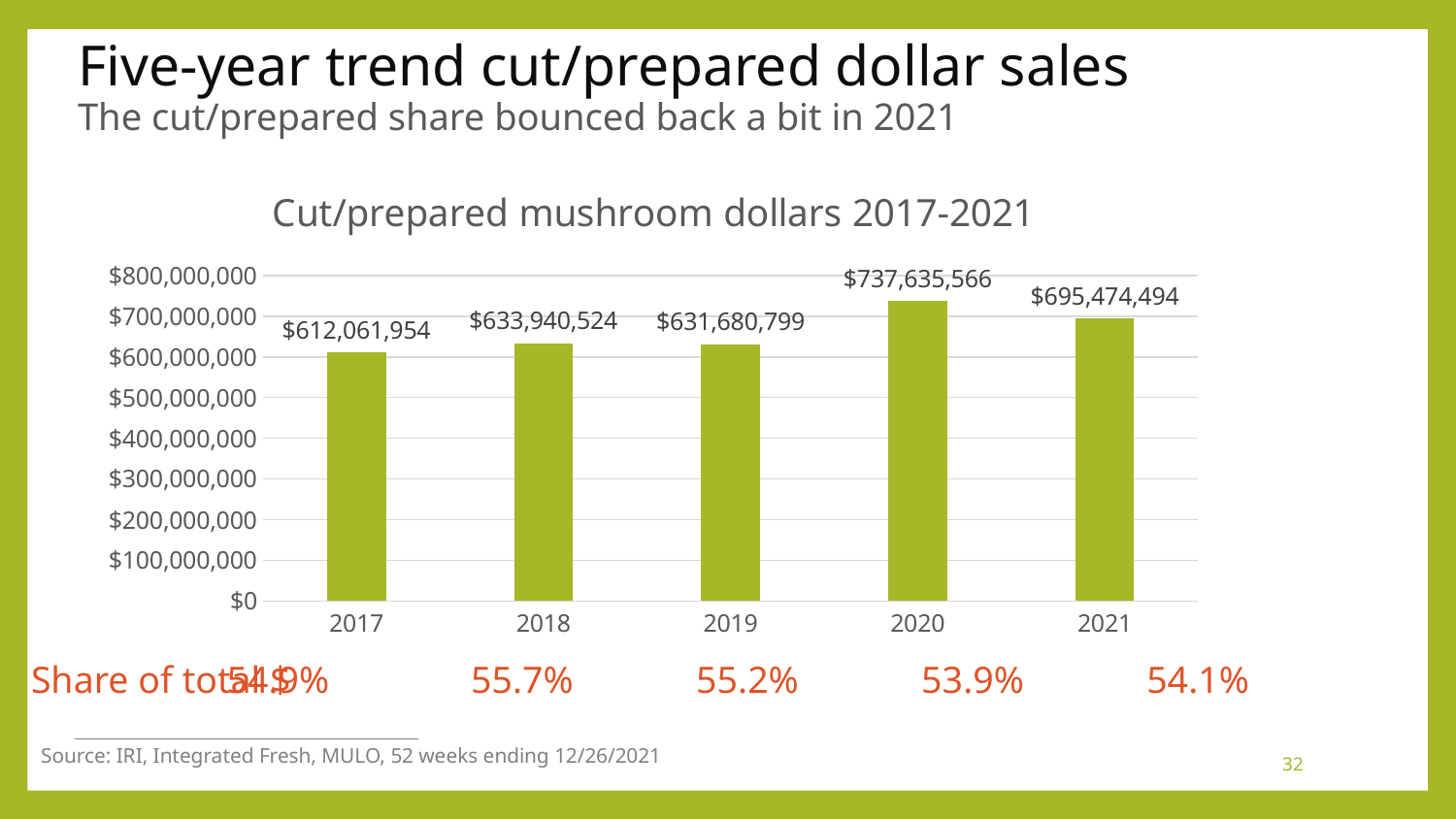
Did cut/prepared mushroom dollar sales rise or fall from 2020 to 2021? Fall Which is larger, the value for 2018 or the value for 2019? 2018 Which year has the lowest cut/prepared mushroom dollar sales? 2017 What is the value for 2021 in the Cut/prepared mushroom dollars 2017-2021 chart? $695,474,494 What is the value for 2020 in the Cut/prepared mushroom dollars 2017-2021 chart? $737,635,566 What kind of chart is shown on the slide? Bar chart What is the title of the chart on the slide? Cut/prepared mushroom dollars 2017-2021 Is the value for 2021 greater or less than $600,000,000? greater What is the difference between the 2020 and 2021 values in the chart? $42,161,072 How many years are shown on the x axis of the chart? 5 Which year has the highest cut/prepared mushroom dollar sales? 2020 What is the value for 2017 in the Cut/prepared mushroom dollars 2017-2021 chart? $612,061,954